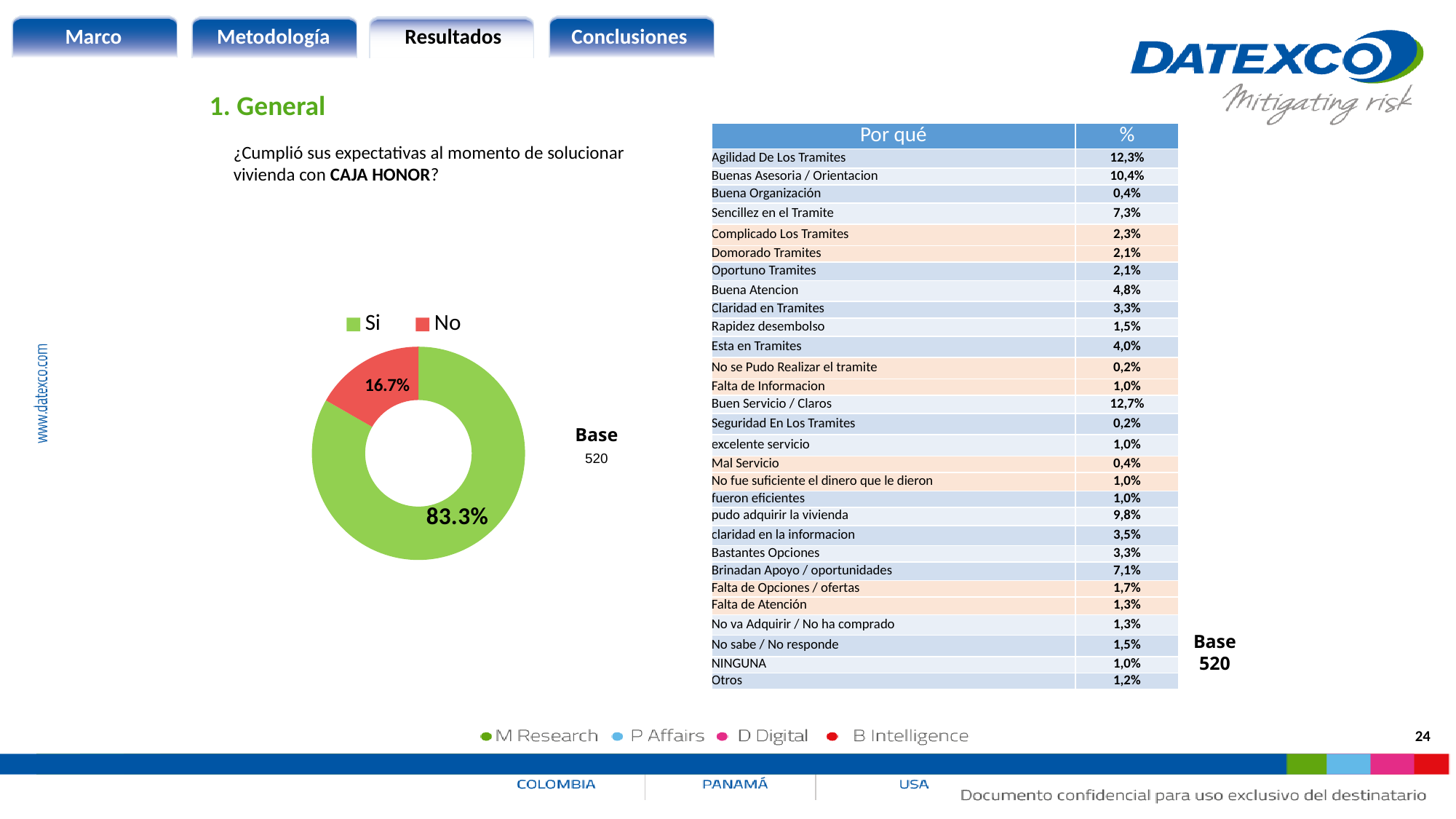
What share of the donut chart does the "No" slice represent? 16.7% How many entries does the legend of the donut chart list? 2 Which category has the smallest share in the donut chart? No What percentage of the donut chart is labelled "Si"? 83.3% What type of chart is shown on the left of the slide? Pie (donut) chart What is the difference in percentage points between the "Si" and "No" slices of the donut chart? 66.6% What percentage of the donut chart is labelled "No"? 16.7% Which category has the largest share in the donut chart? Si How many slices does the donut chart have? 2 What colour represents "Si" in the donut chart? Green Which slice is larger in the donut chart, "Si" or "No"? Si What is the base (number of respondents) shown next to the donut chart? 520